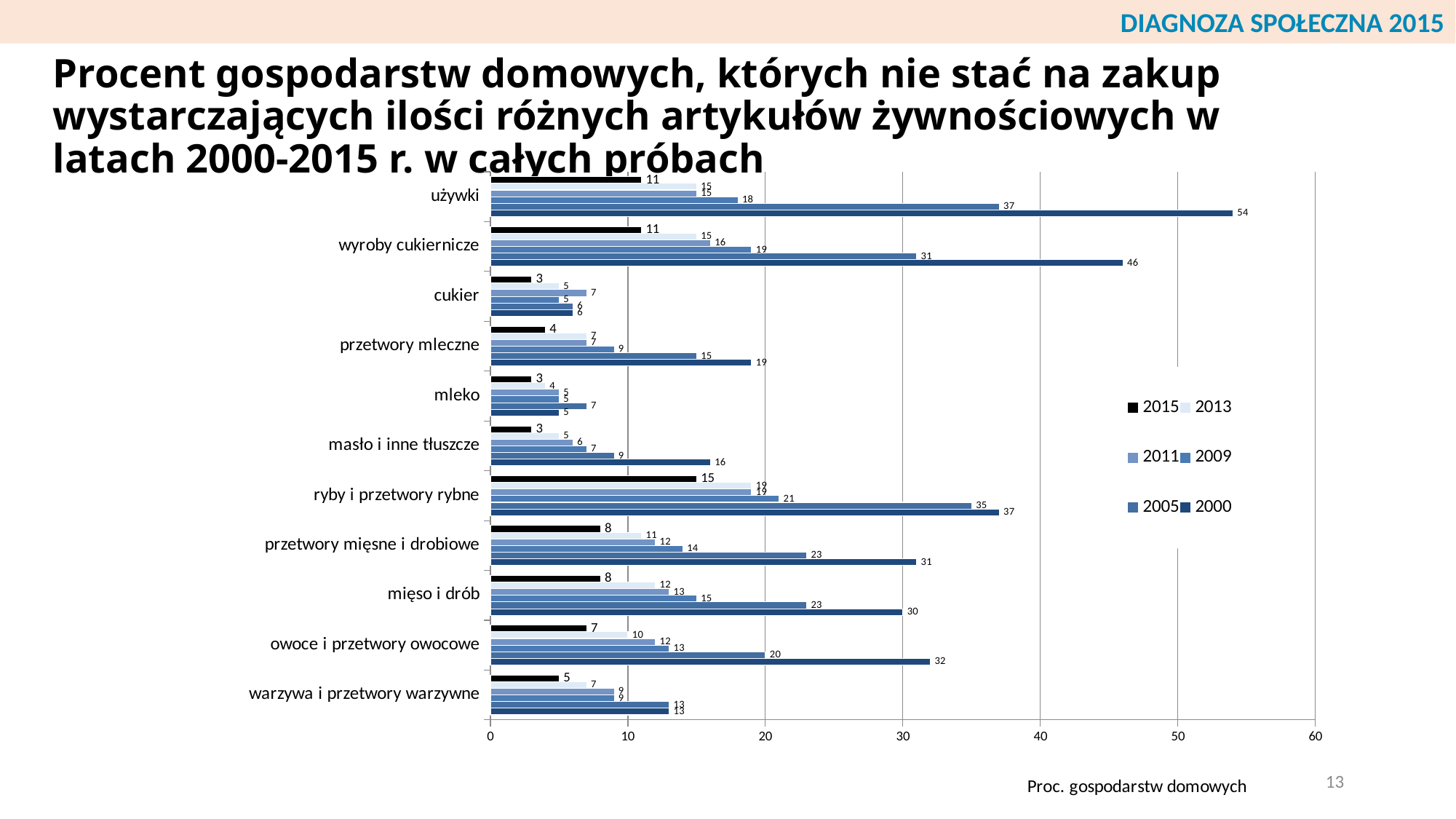
What is the difference between the 2000 and 2015 values for używki? 43 How many series does the legend list? 6 What is the value for ryby i przetwory rybne in the 2015 series? 15 How many food categories are shown on the chart? 11 What kind of chart is shown on the slide? bar chart What is the label shown below the horizontal axis of the chart? Proc. gospodarstw domowych Is the value for owoce i przetwory owocowe in the 2000 series greater or less than 30? greater Which category has the highest value in the 2000 series? używki What is the value for mięso i drób in the 2005 series? 23 In the 2000 series, which is larger: wyroby cukiernicze or ryby i przetwory rybne? wyroby cukiernicze Which category has the highest value in the 2015 series? ryby i przetwory rybne What is the value for używki in the 2000 series? 54